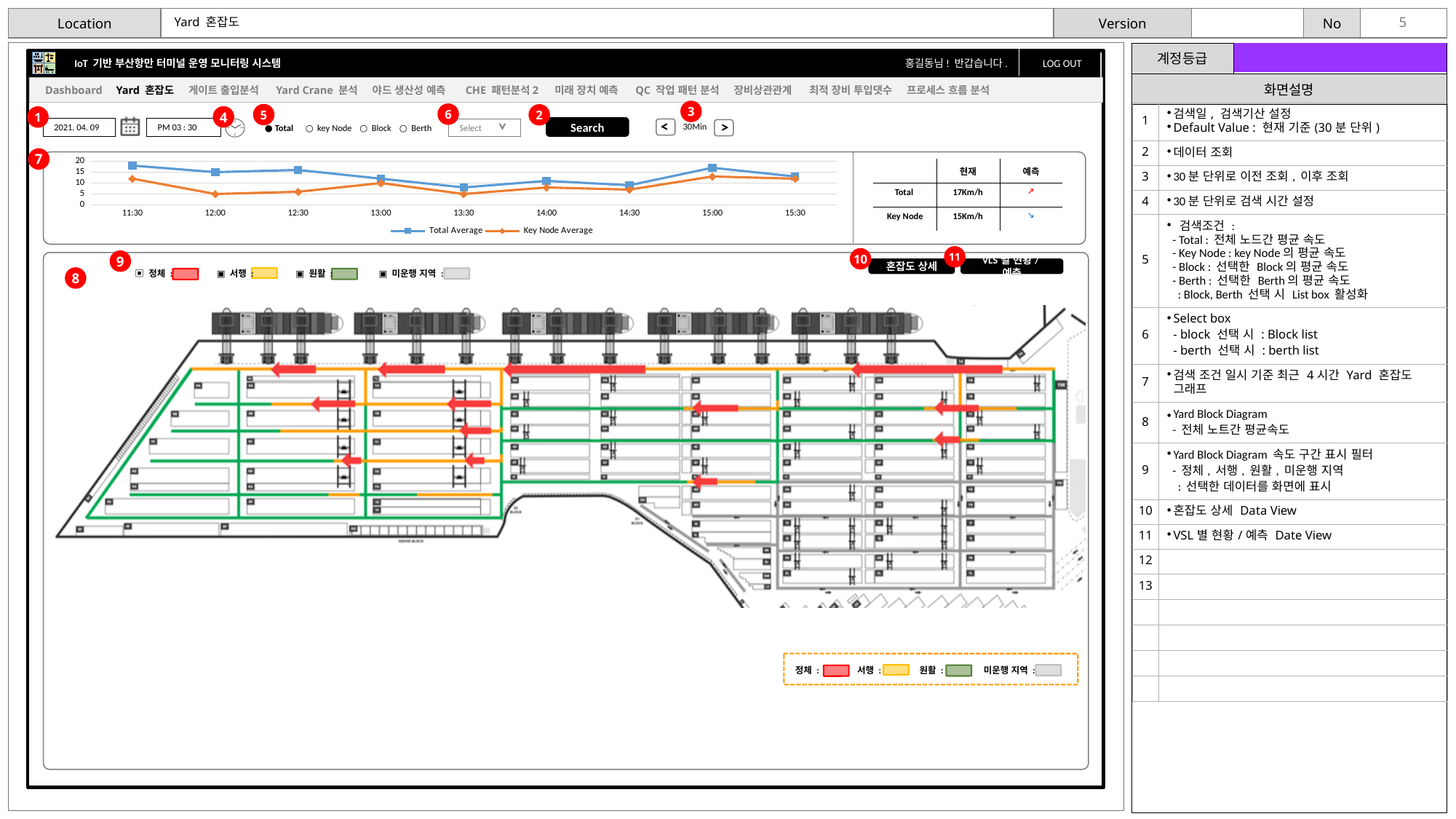
Does the Key Node Average series rise or fall between 13:30 and 15:00? rise Is the Total Average value at 11:30 greater or less than 15? greater What is the first time label on the x axis of the line chart? 11:30 At which time does the Key Node Average series reach its highest value? 15:00 Is the Key Node Average value at 15:00 greater or less than 10? greater What kind of chart is shown at the top of the slide (the Yard 혼잡도 graph)? line chart Is the Total Average value at 13:30 greater or less than 10? less What are the two series named in the line chart's legend? Total Average and Key Node Average At 12:00, which series has the higher value, Total Average or Key Node Average? Total Average How many series does the legend of the line chart list? 2 How many time points are shown along the x axis of the line chart? 9